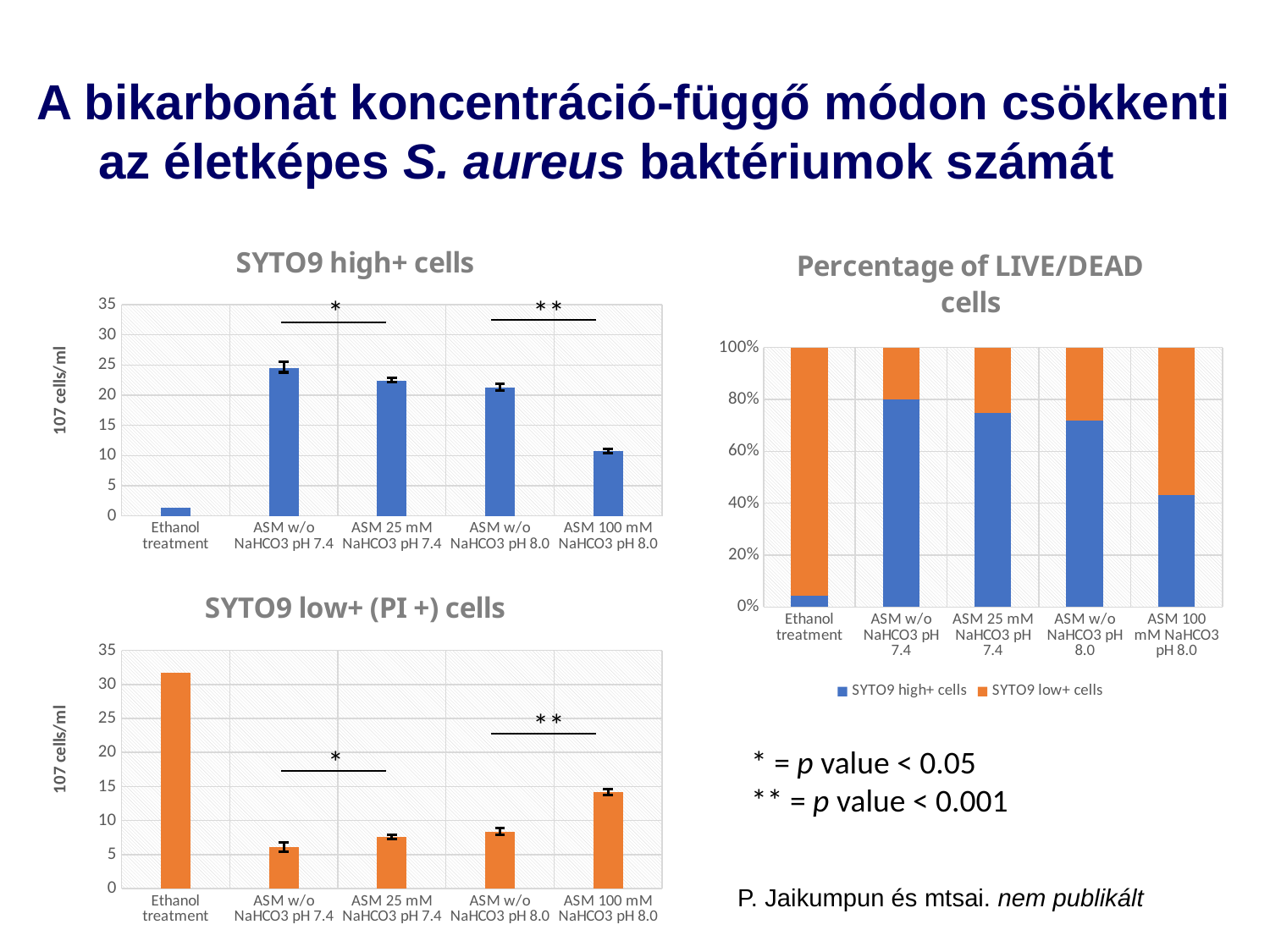
In the SYTO9 low+ (PI +) cells chart, which category has the highest value? Ethanol treatment In the SYTO9 high+ cells chart, is the value for ASM 100 mM NaHCO3 pH 8.0 greater or less than 15? less In the SYTO9 high+ cells chart, which is larger: ASM 25 mM NaHCO3 pH 7.4 or ASM 100 mM NaHCO3 pH 8.0? ASM 25 mM NaHCO3 pH 7.4 How many categories are shown on the x axis of the SYTO9 low+ (PI +) cells chart? 5 How many series does the legend of the Percentage of LIVE/DEAD cells chart list? 2 In the SYTO9 low+ (PI +) cells chart, is the value for Ethanol treatment greater or less than 30? greater What kind of chart is the Percentage of LIVE/DEAD cells chart? stacked bar chart In the SYTO9 high+ cells chart, which category has the highest value? ASM w/o NaHCO3 pH 7.4 In the SYTO9 low+ (PI +) cells chart, which is larger: ASM 100 mM NaHCO3 pH 8.0 or ASM 25 mM NaHCO3 pH 7.4? ASM 100 mM NaHCO3 pH 8.0 In the SYTO9 high+ cells chart, is the value for ASM w/o NaHCO3 pH 7.4 greater or less than 20? greater In the SYTO9 high+ cells chart, which category has the lowest value? Ethanol treatment